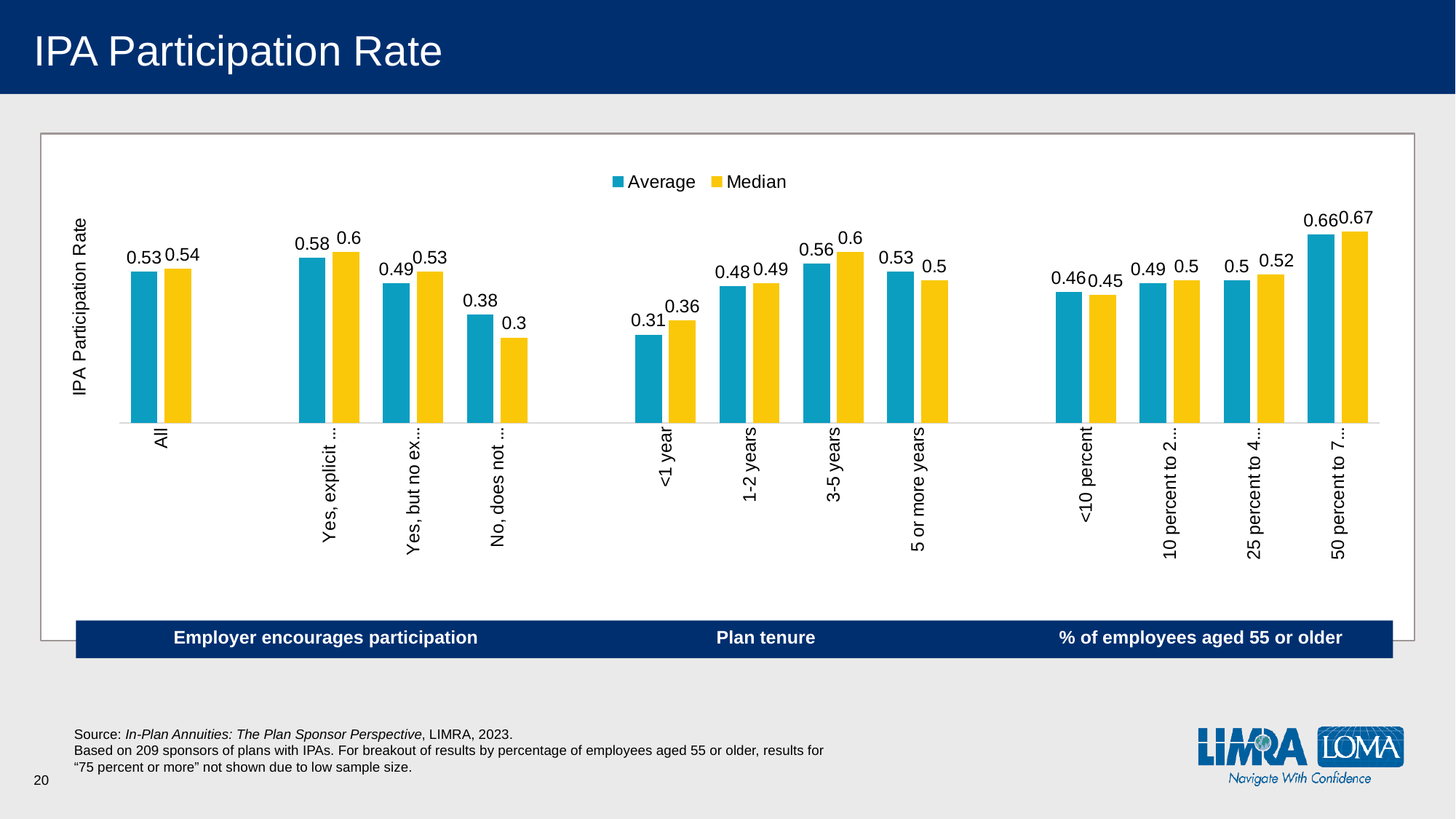
What is the Median IPA Participation Rate for plans where <10 percent of employees are aged 55 or older? 0.45 What type of chart is shown on the slide? Bar chart Which colour represents the Median series in the chart? Yellow What is the difference between the Median and Average IPA Participation Rate for plans with a tenure of <1 year? 0.05 What is the Average IPA Participation Rate for the "All" category? 0.53 Which plan tenure category has the lowest Average IPA Participation Rate? <1 year How many series does the legend list? 2 How many categories are plotted along the x axis? 12 What is the Median IPA Participation Rate for plans with a tenure of 3-5 years? 0.6 What is the Average IPA Participation Rate for plans with a tenure of <1 year? 0.31 Which plan tenure category has the highest Median IPA Participation Rate? 3-5 years For plans with a tenure of 5 or more years, is the Average or the Median IPA Participation Rate higher? Average